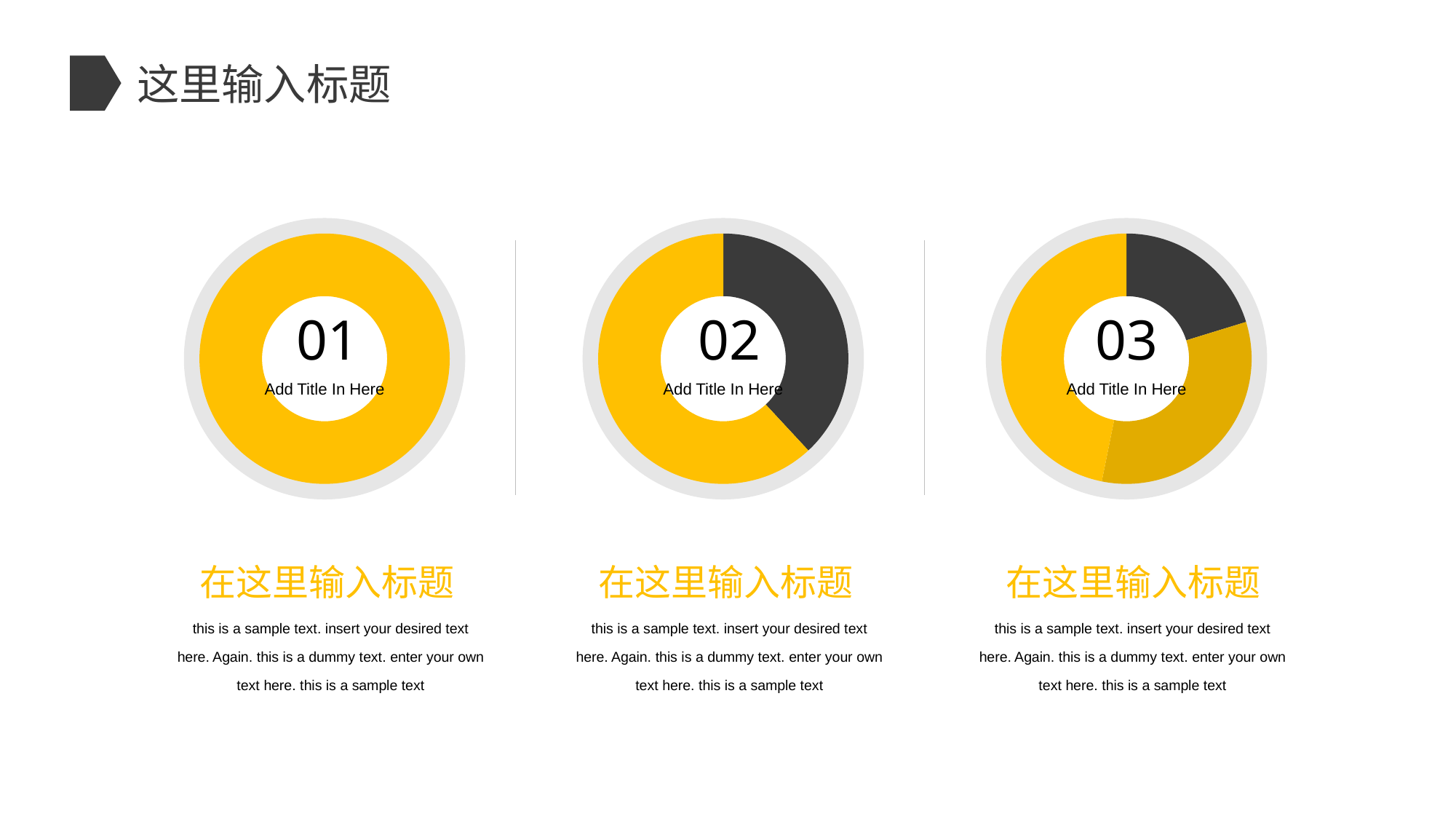
In the chart labelled 03, which slice is larger, the dark grey one or the darker yellow one? the darker yellow one In the chart labelled 02, which slice is larger, the yellow one or the dark grey one? the yellow one How many doughnut charts are shown on the slide? 3 In the chart labelled 02, does the yellow slice cover more or less than half of the ring? more In the chart labelled 03, how many slices does the ring have? 3 What colour is the single slice of the chart labelled 01? yellow In the chart labelled 01, how many slices does the ring have? 1 What kind of chart is the chart labelled 02? doughnut chart In the chart labelled 03, which slice is the smallest? the dark grey slice What text appears below the number in the centre of each doughnut chart? Add Title In Here